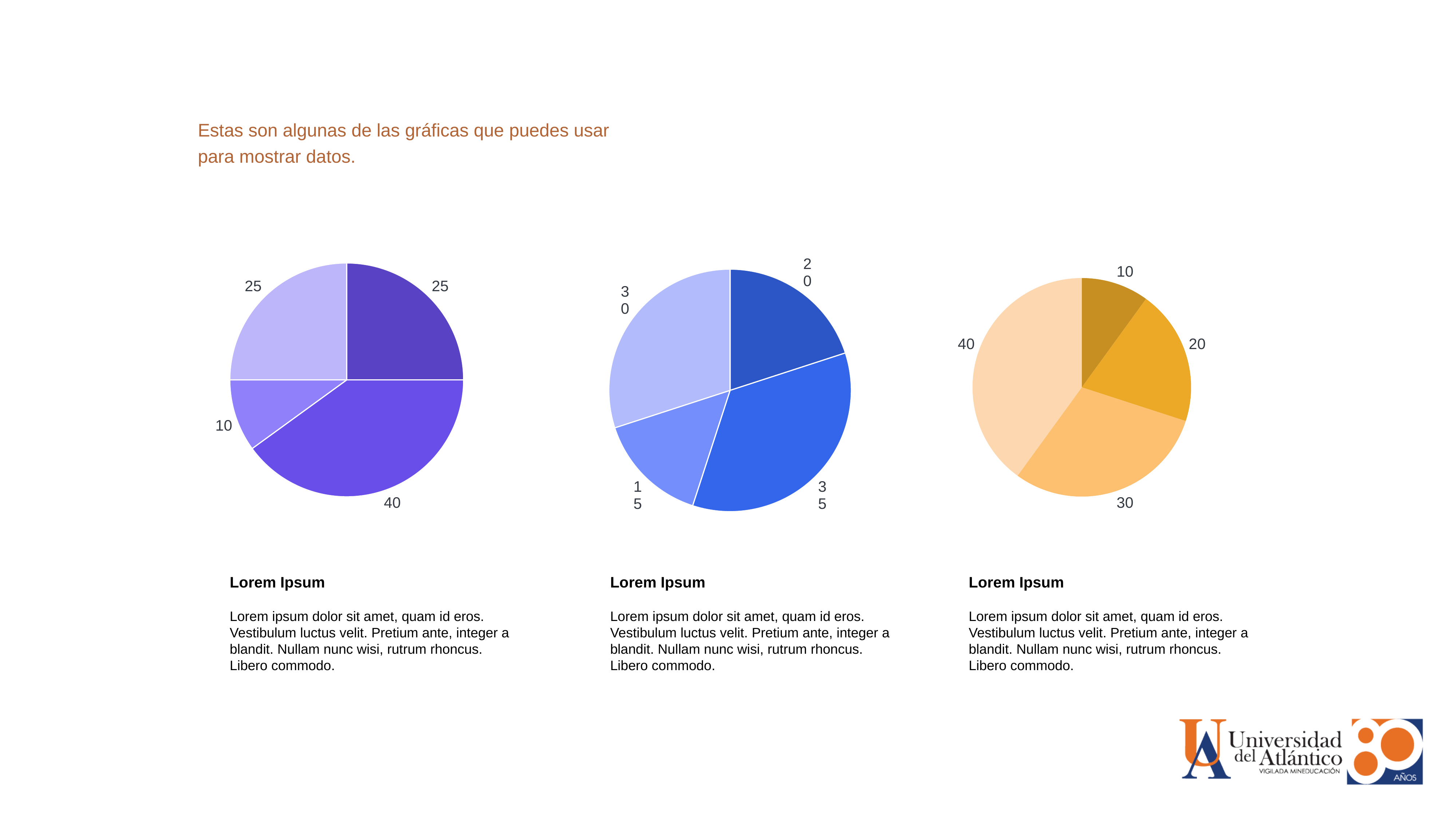
In the middle pie chart, what is the difference between the slice labelled 30 and the slice labelled 20? 10 What kind of chart is the left chart on the slide? pie chart What is the value of the smallest slice in the middle pie chart? 15 What is the value of the largest slice in the right pie chart? 40 In the right pie chart, what is the value of the darkest slice? 10 In the right pie chart, what share of the whole pie does the slice labelled 10 represent? 10% In the left pie chart, what is the difference between the largest slice and the smallest slice? 30 What is the value of the largest slice in the middle pie chart? 35 What is the value of the largest slice in the left pie chart? 40 How many slices does the left pie chart have? 4 How many slices does the middle pie chart have? 4 What is the value of the smallest slice in the left pie chart? 10